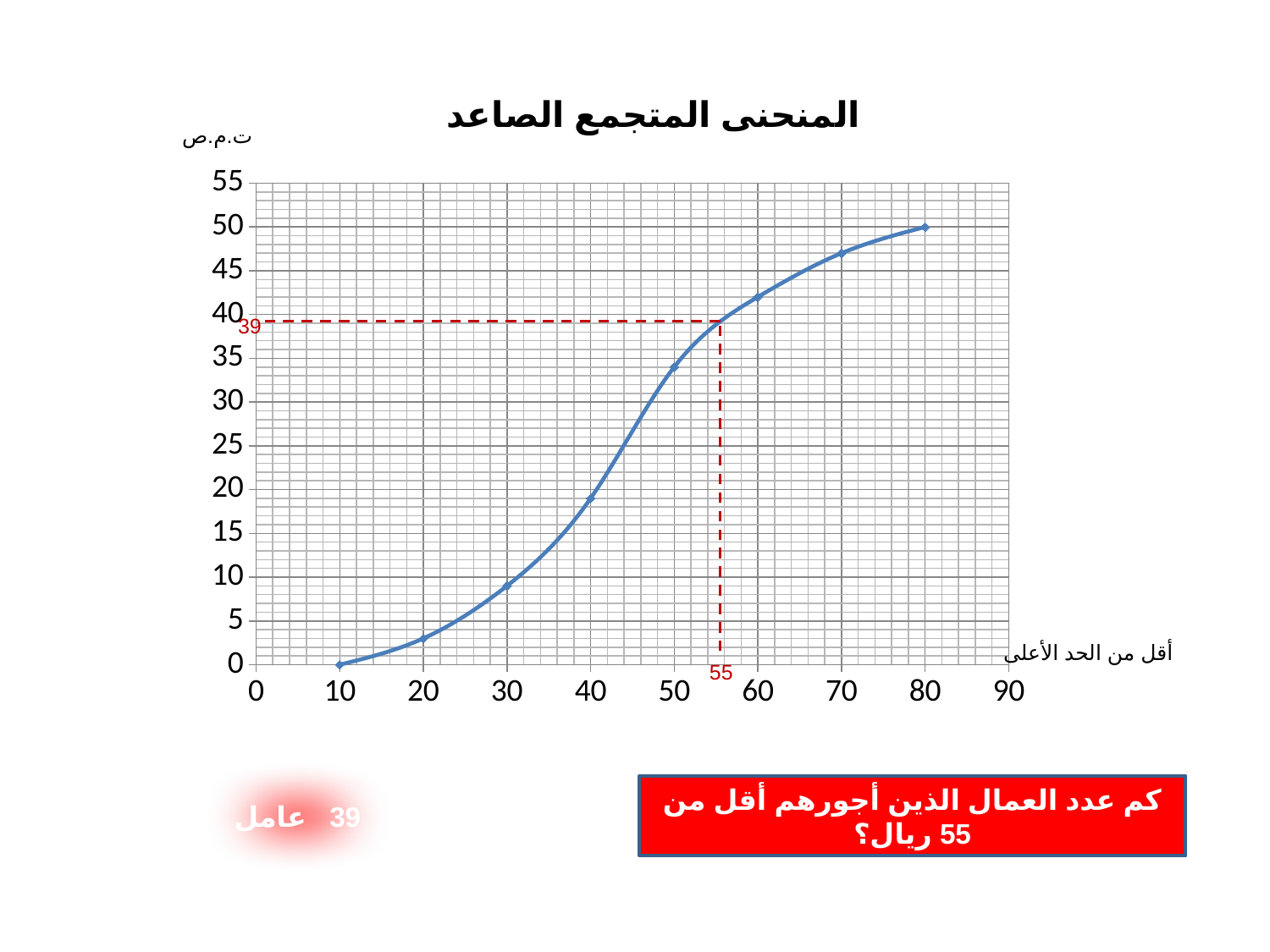
What kind of chart is shown on the slide? line chart At which x value is the cumulative frequency lowest? 10 What is the title of the chart? المنحنى المتجمع الصاعد What is the cumulative frequency at x = 10? 0 Do the values rise or fall as the x-axis value increases? rise At which x value is the cumulative frequency highest? 80 According to the dashed reference lines, what cumulative frequency corresponds to x = 55? 39 Is the value at x = 50 greater or less than 30? greater How many data points are plotted on the curve? 8 Which has the larger cumulative frequency, x = 60 or x = 40? 60 What is the cumulative frequency at x = 80? 50